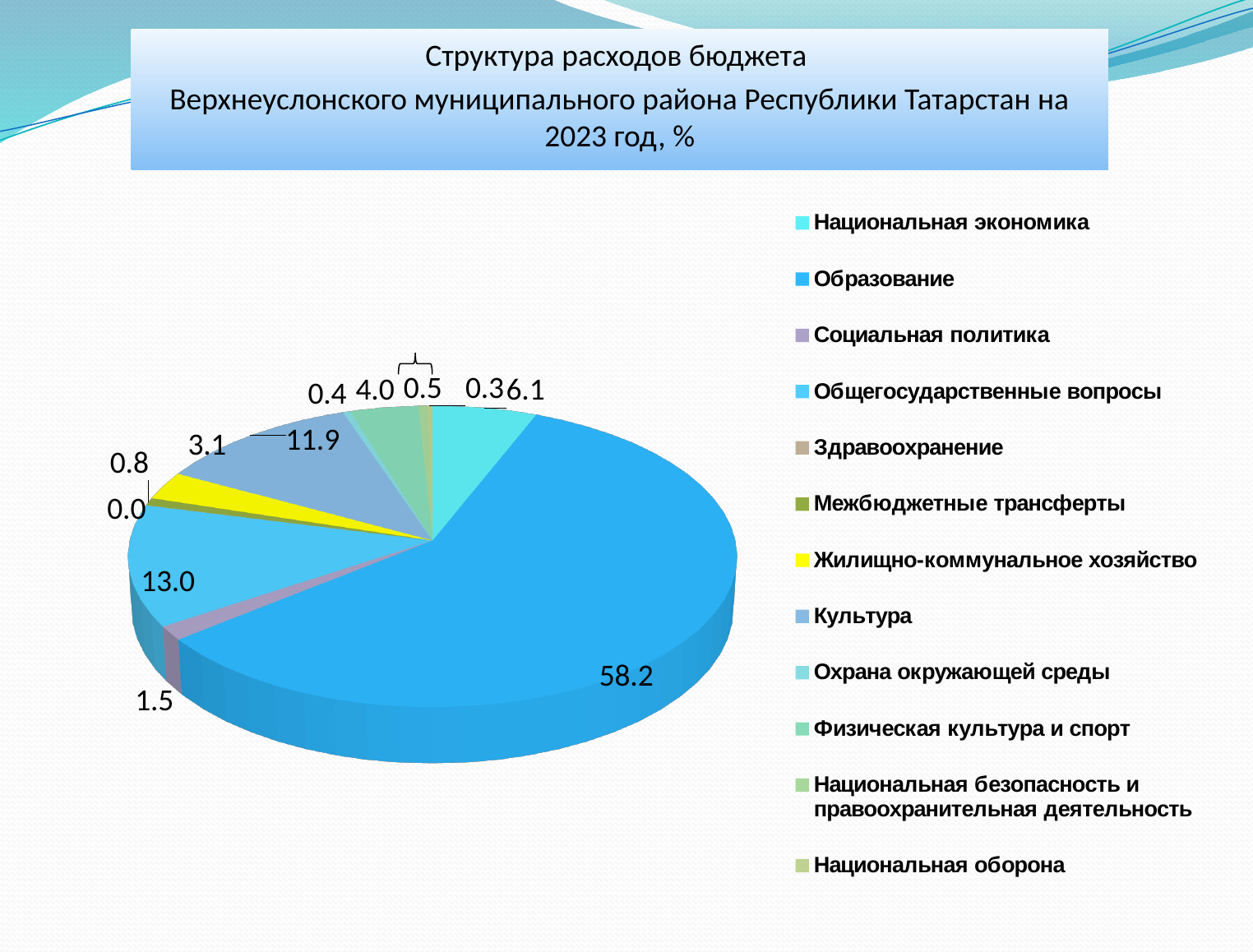
What is the difference between the values for Национальная экономика and Социальная политика? 4.6 What is the value for Общегосударственные вопросы? 13.0 What is the value for Образование? 58.2 What is the difference between the values for Образование and Общегосударственные вопросы? 45.2 What is the value for Социальная политика? 1.5 What is the value for Национальная экономика? 6.1 Which category has the largest share of the pie? Образование How many categories does the legend list? 12 What year does the chart title refer to? 2023 What is the value for Культура? 11.9 What kind of chart is shown on the slide? pie chart Which is larger, the value for Общегосударственные вопросы or the value for Культура? Общегосударственные вопросы